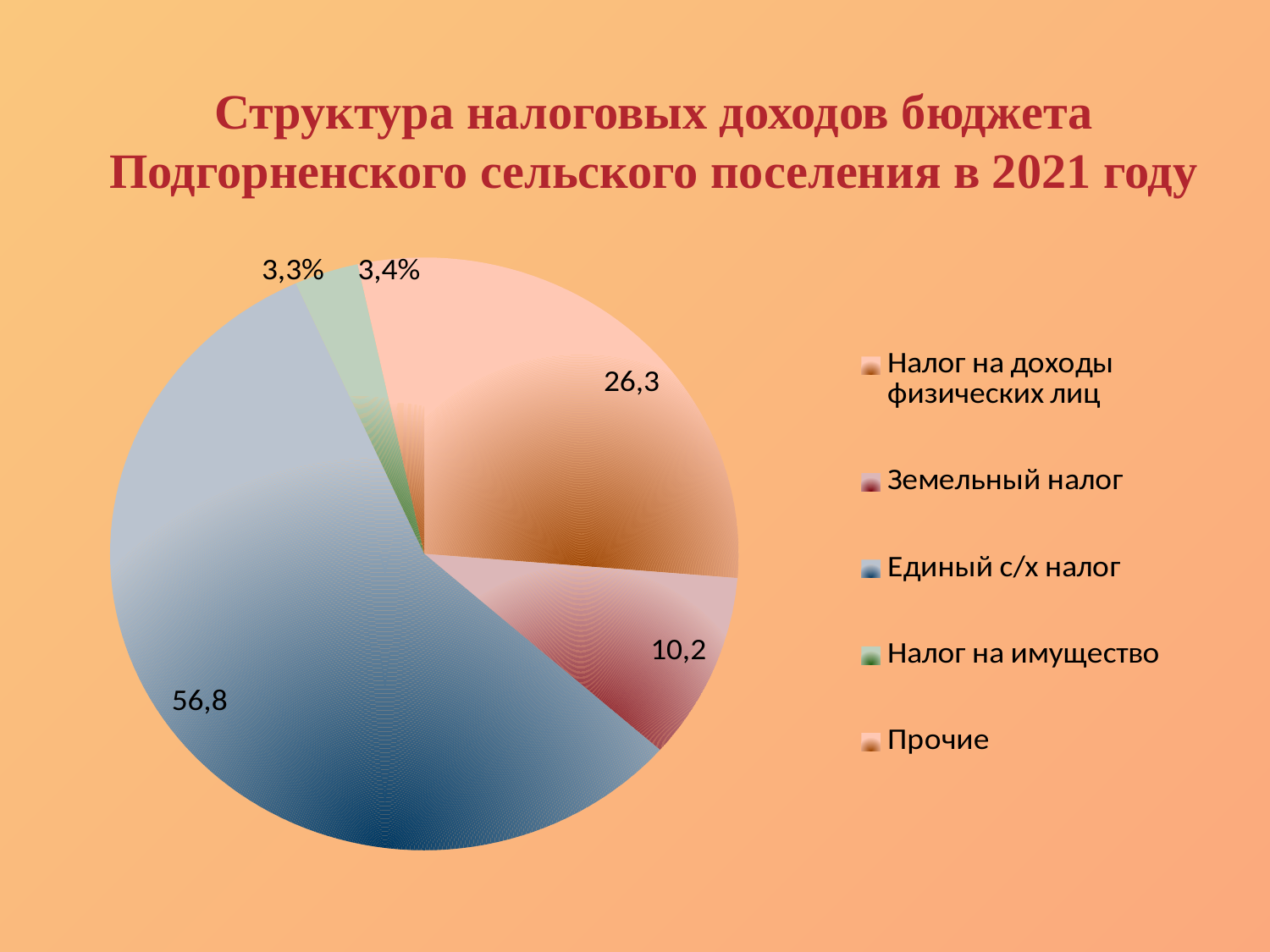
How many entries does the legend list? 5 What is the title of the slide? Структура налоговых доходов бюджета Подгорненского сельского поселения в 2021 году What is the difference between the values for Единый с/х налог and Налог на доходы физических лиц? 30,5 What is the value shown for Единый с/х налог? 56,8 Which category has the largest slice of the pie? Единый с/х налог What is the value shown for Земельный налог? 10,2 What is the value shown for Налог на имущество? 3,3% What is the value shown for Налог на доходы физических лиц? 26,3 What type of chart is shown on the slide? pie chart Which is larger, Налог на доходы физических лиц or Земельный налог? Налог на доходы физических лиц What is the difference between the values for Налог на доходы физических лиц and Земельный налог? 16,1 How many categories does the pie chart have? 5